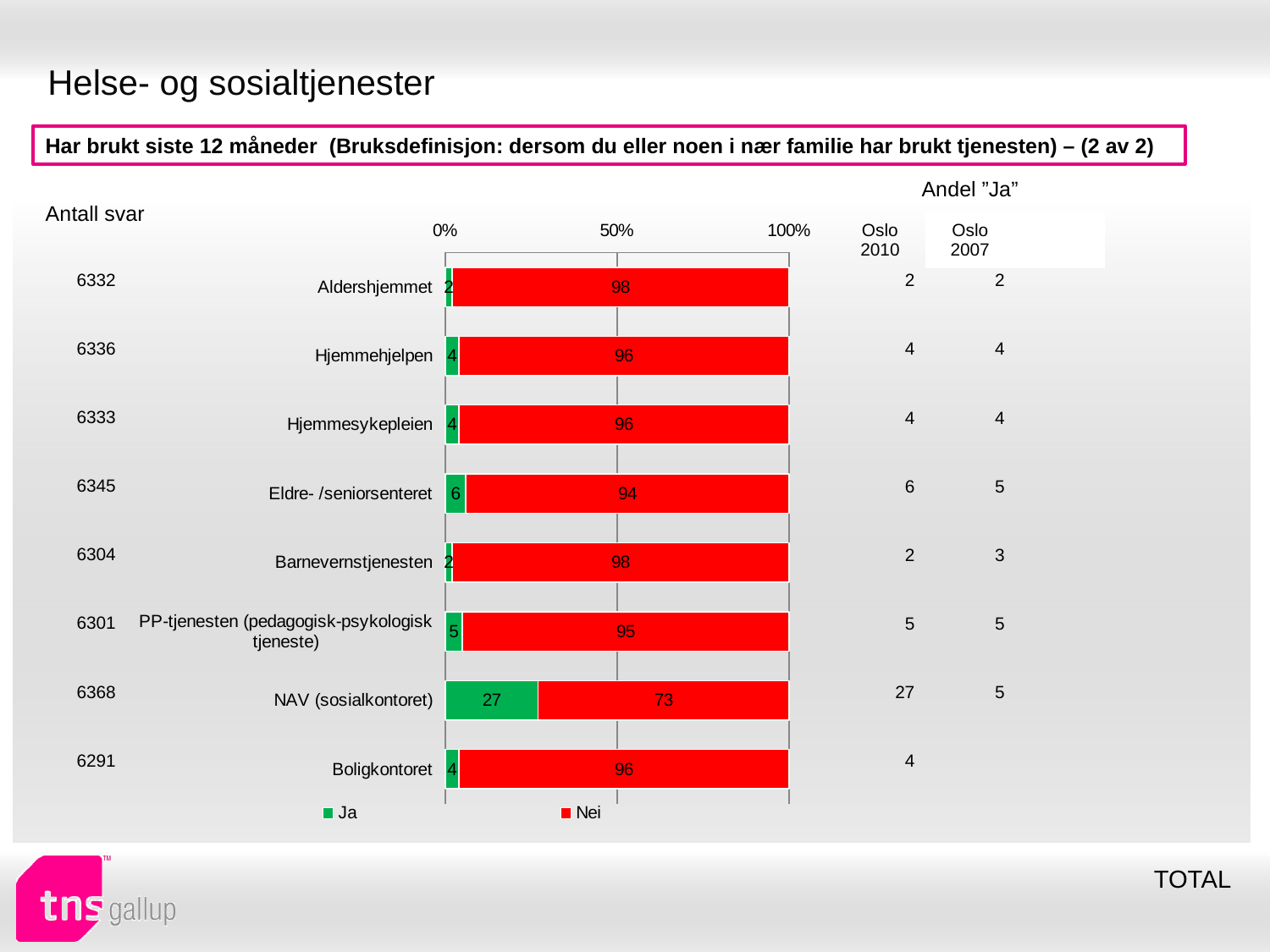
Which category has the lowest "Nei" value? NAV (sosialkontoret) What is the total of the stacked bar for PP-tjenesten (pedagogisk-psykologisk tjeneste)? 100 What is the difference between the "Nei" values for Aldershjemmet and NAV (sosialkontoret)? 25 What is the "Nei" value for NAV (sosialkontoret)? 73 How many series does the legend list? 2 What is the "Ja" value for Eldre- /seniorsenteret? 6 Which category has the highest "Ja" value? NAV (sosialkontoret) What is the "Nei" value for Aldershjemmet? 98 Which is larger, the "Ja" value for Eldre- /seniorsenteret or the "Ja" value for Hjemmehjelpen? Eldre- /seniorsenteret Is the "Nei" value for NAV (sosialkontoret) greater or less than 50%? greater How many categories are shown in the chart? 8 What kind of chart is shown on the slide? Stacked bar chart